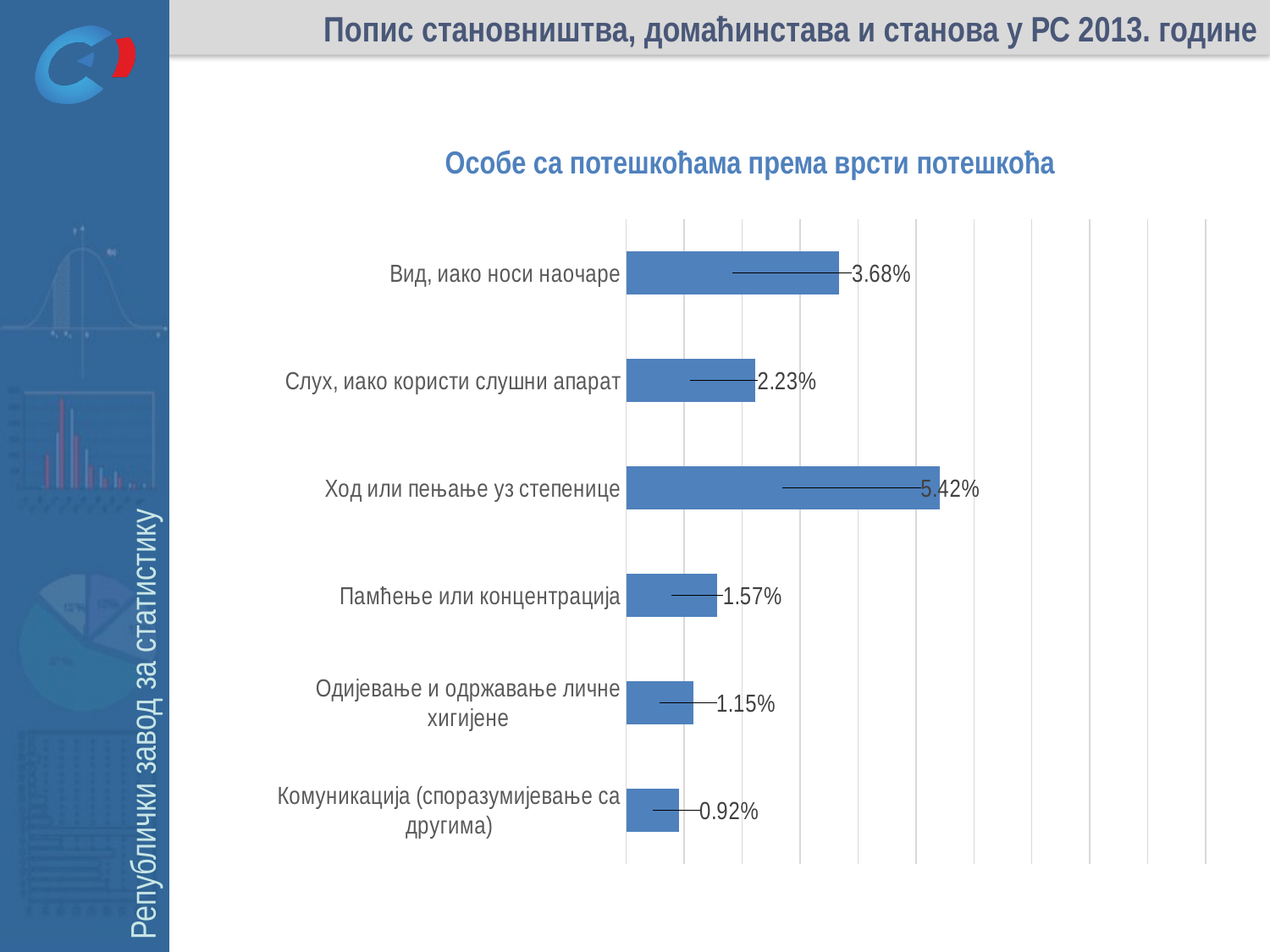
What is the title of the chart? Особе са потешкоћама према врсти потешкоћа What is the value for "Комуникација (споразумијевање са другима)"? 0.92% What is the value for "Ход или пењање уз степенице"? 5.42% What is the difference between the values for "Слух, иако користи слушни апарат" and "Одијевање и одржавање личне хигијене"? 1.08% What is the value for "Вид, иако носи наочаре"? 3.68% How many categories are shown in the chart? 6 Which is larger, the value for "Слух, иако користи слушни апарат" or the value for "Памћење или концентрација"? Слух, иако користи слушни апарат Which category has the lowest value? Комуникација (споразумијевање са другима) Which category has the highest value? Ход или пењање уз степенице What kind of chart is shown on the slide? Bar chart What is the difference between the values for "Ход или пењање уз степенице" and "Вид, иако носи наочаре"? 1.74% What is the value for "Памћење или концентрација"? 1.57%